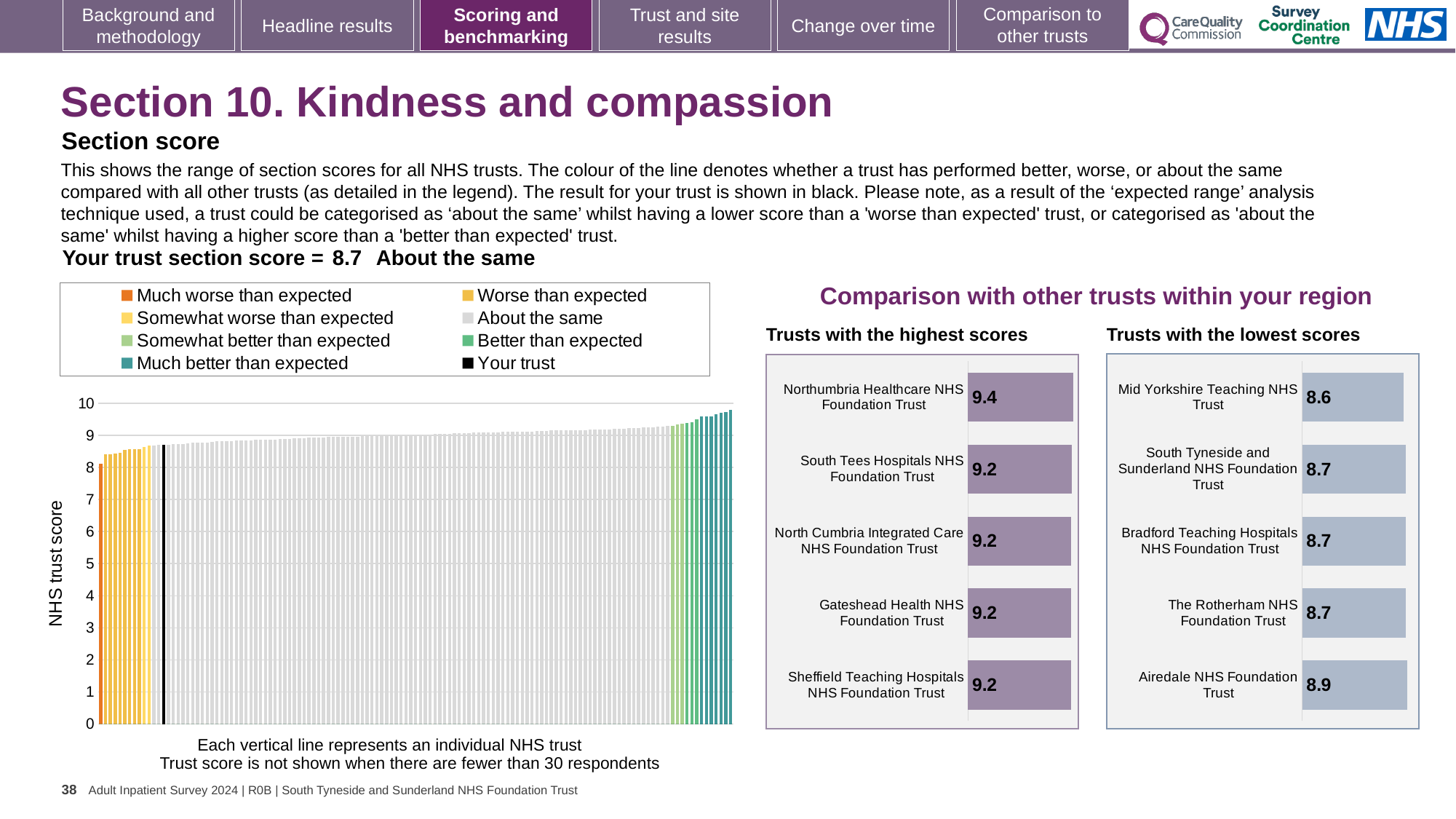
In the 'Trusts with the lowest scores' chart, what is the score for Airedale NHS Foundation Trust? 8.9 In the 'Trusts with the highest scores' chart, which trust has the highest score? Northumbria Healthcare NHS Foundation Trust In the 'Trusts with the lowest scores' chart, which trust has the lowest score? Mid Yorkshire Teaching NHS Trust In the large 'NHS trust score' chart on the left, do the bar values rise or fall from left to right along the x axis? rise In the 'Trusts with the highest scores' chart, what is the difference between the score for Northumbria Healthcare NHS Foundation Trust and the score for South Tees Hospitals NHS Foundation Trust? 0.2 In the 'Trusts with the highest scores' chart, what is the score for Northumbria Healthcare NHS Foundation Trust? 9.4 How many trusts are shown in the 'Trusts with the lowest scores' chart? 5 Which is larger: the score for Northumbria Healthcare NHS Foundation Trust in the 'Trusts with the highest scores' chart, or the score for Airedale NHS Foundation Trust in the 'Trusts with the lowest scores' chart? Northumbria Healthcare NHS Foundation Trust What kind of chart is the large 'NHS trust score' chart on the left? bar chart In the large 'NHS trust score' chart on the left, is the value of the black 'Your trust' bar greater or less than 9? less How many entries does the legend of the large 'NHS trust score' chart on the left list? 8 In the 'Trusts with the lowest scores' chart, what is the difference between the score for Airedale NHS Foundation Trust and the score for Mid Yorkshire Teaching NHS Trust? 0.3